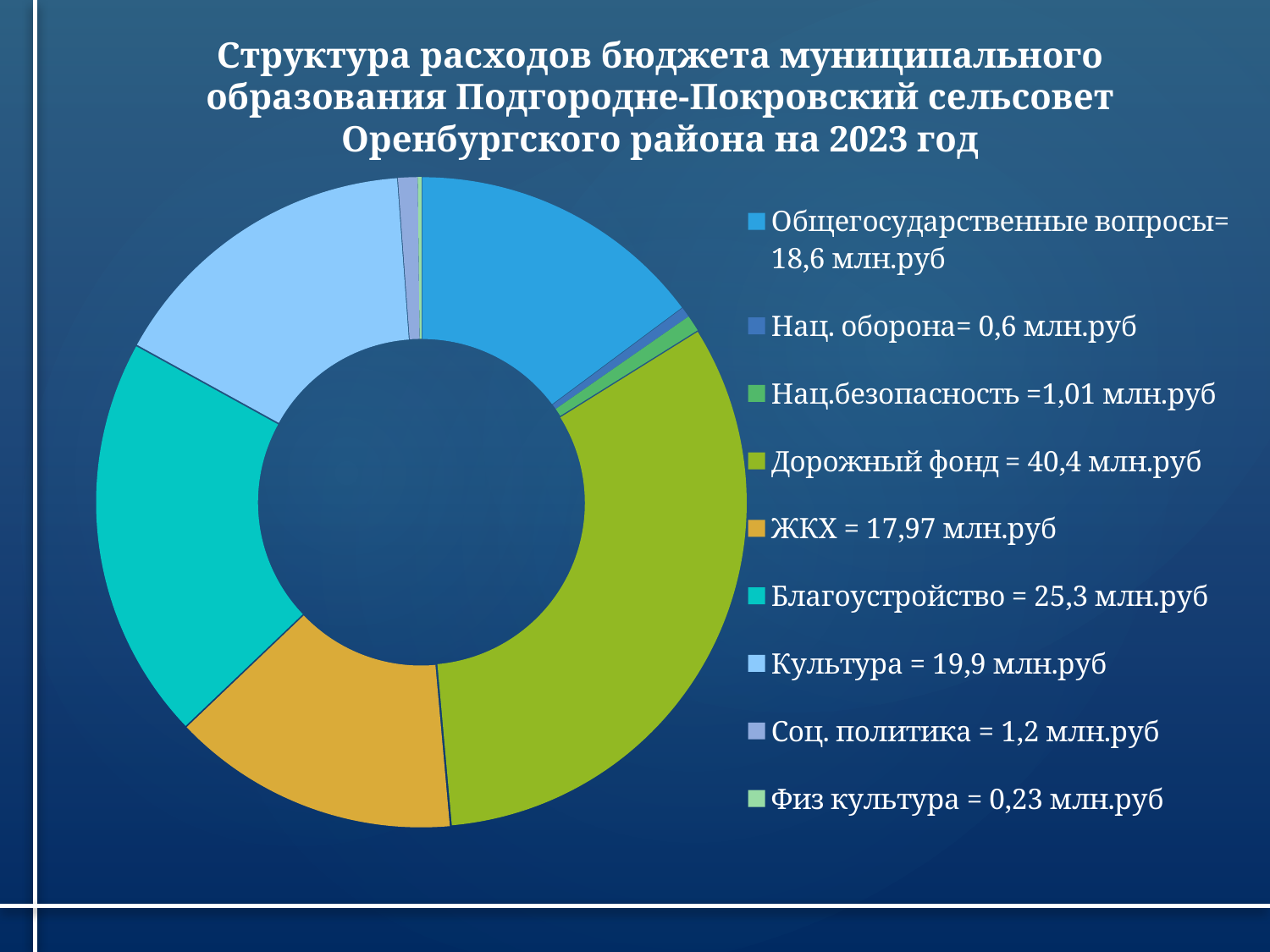
What is the value for Дорожный фонд? 40,4 млн.руб Which category has the largest expenditure? Дорожный фонд Which is larger, Культура or Общегосударственные вопросы? Культура Which is larger, Соц. политика or Нац. оборона? Соц. политика What kind of chart is shown on the slide? Doughnut (pie) chart What is the value for Благоустройство? 25,3 млн.руб What is the difference between Дорожный фонд and Благоустройство? 15,1 млн.руб How many categories does the chart show? 9 What is the difference between Культура and Общегосударственные вопросы? 1,3 млн.руб What is the value for ЖКХ? 17,97 млн.руб Which category has the smallest expenditure? Физ культура What is the value for Нац.безопасность? 1,01 млн.руб